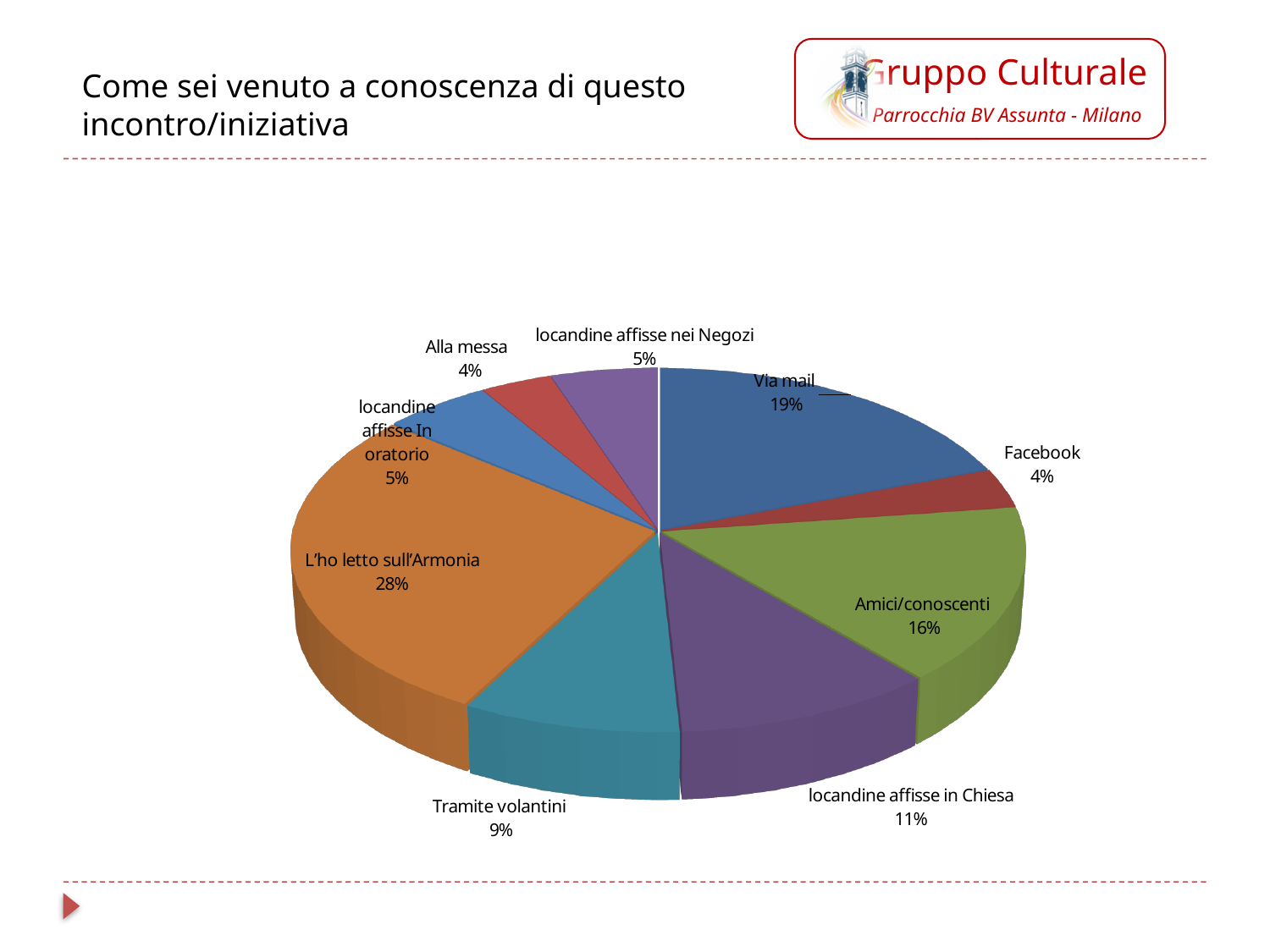
What percentage is shown for "Amici/conoscenti"? 16% Which is larger, the share for "Amici/conoscenti" or the share for "locandine affisse in Chiesa"? Amici/conoscenti What is the title of the slide containing the chart? Come sei venuto a conoscenza di questo incontro/iniziativa What percentage is shown for "Tramite volantini"? 9% What kind of chart is shown on the slide? Pie chart Which category has the largest share of the pie? L'ho letto sull'Armonia How many categories are shown in the pie chart? 9 What percentage is shown for "Via mail"? 19% What is the difference in percentage points between "Via mail" and "Facebook"? 15 What is the difference in percentage points between "L'ho letto sull'Armonia" and "Via mail"? 9 What share of the pie does "L'ho letto sull'Armonia" represent? 28% What percentage is shown for "locandine affisse in Chiesa"? 11%